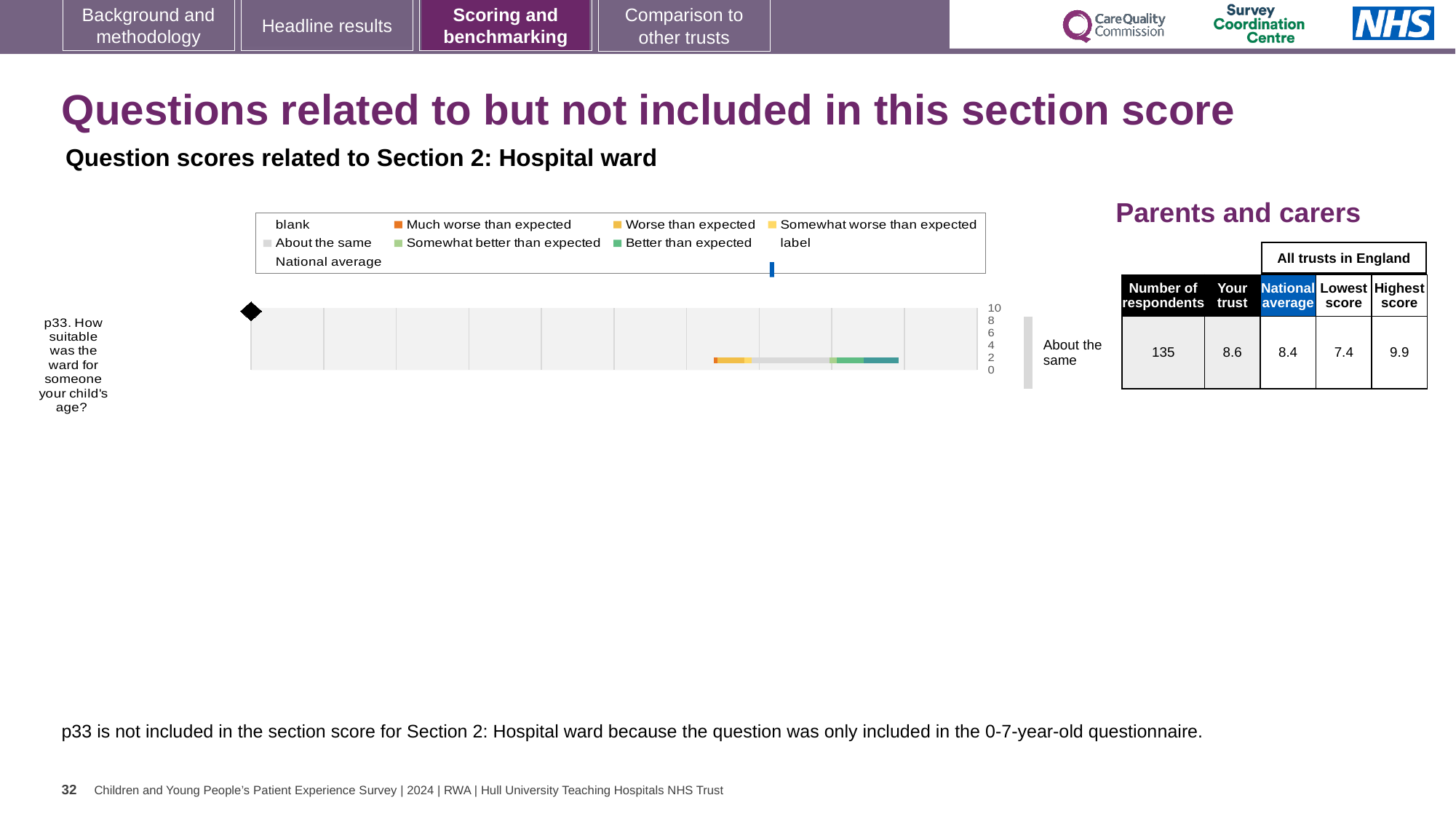
In the table beside the chart, what is the 'Your trust' score for p33? 8.6 What is the highest value shown on the chart's axis? 10 What is the difference between the highest score and the lowest score for p33 in the table? 2.5 What is the difference between the 'Your trust' score and the national average for p33? 0.2 In the table beside the chart, how many respondents answered p33? 135 Which is larger for p33: the 'Your trust' score or the national average? Your trust What benchmark category label is shown to the right of the p33 bar? About the same How many questions (categories) are plotted in the chart? 1 In the table beside the chart, what is the national average score for p33? 8.4 What kind of chart is shown for question p33? bar chart In the table beside the chart, what is the lowest score among all trusts in England for p33? 7.4 In the table beside the chart, what is the highest score among all trusts in England for p33? 9.9